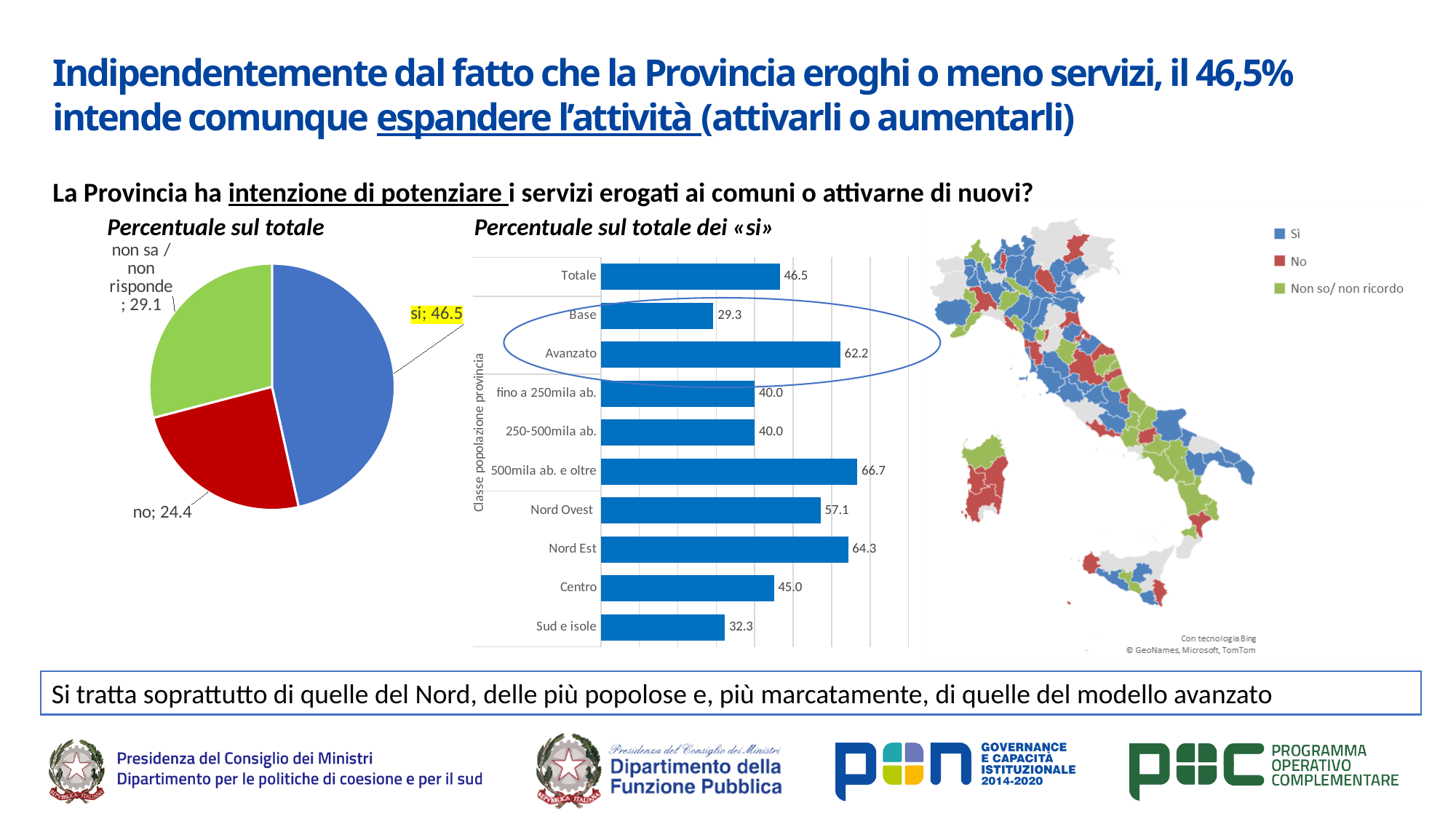
In the pie chart 'Percentuale sul totale', what is the value of the 'si' slice? 46.5 In the pie chart 'Percentuale sul totale', which slice is the smallest? no In the bar chart 'Percentuale sul totale dei «si»', which is larger, 'Nord Est' or 'Nord Ovest'? Nord Est In the pie chart 'Percentuale sul totale', how many slices are there? 3 In the bar chart 'Percentuale sul totale dei «si»', what is the value for 'Avanzato'? 62.2 In the bar chart 'Percentuale sul totale dei «si»', what is the value for 'Sud e isole'? 32.3 In the pie chart 'Percentuale sul totale', what is the value of the 'no' slice? 24.4 In the bar chart 'Percentuale sul totale dei «si»', what is the difference between 'Avanzato' and 'Base'? 32.9 In the bar chart 'Percentuale sul totale dei «si»', how many bars are shown? 10 In the bar chart 'Percentuale sul totale dei «si»', which category has the highest value? 500mila ab. e oltre What type of chart is 'Percentuale sul totale dei «si»'? Bar chart In the bar chart 'Percentuale sul totale dei «si»', which category has the lowest value? Base